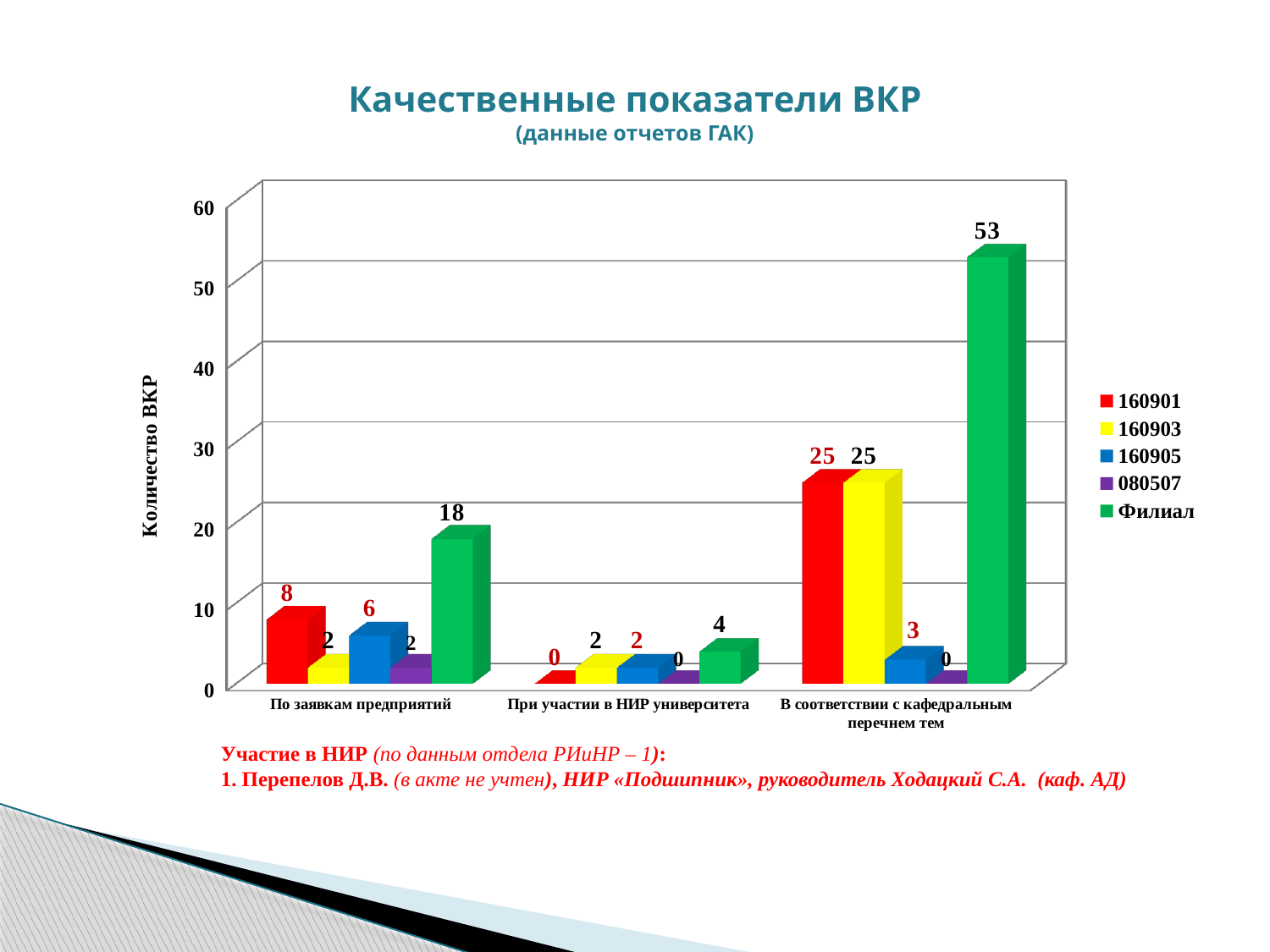
What is the label of the vertical axis? Количество ВКР How many series does the legend list? 5 What is the value for Филиал in the category 'При участии в НИР университета'? 4 What kind of chart is shown on the slide? Bar chart What is the difference between the Филиал value and the 160901 value in the category 'В соответствии с кафедральным перечнем тем'? 28 Which series has the highest value in the category 'По заявкам предприятий'? Филиал Which is larger in the category 'По заявкам предприятий': the value for 160901 or the value for 160905? 160901 How many categories are shown on the x axis? 3 What is the value for Филиал in the category 'В соответствии с кафедральным перечнем тем'? 53 What is the value for 160905 in the category 'В соответствии с кафедральным перечнем тем'? 3 In which category does Филиал have its lowest value? При участии в НИР университета What is the value for 160901 in the category 'По заявкам предприятий'? 8